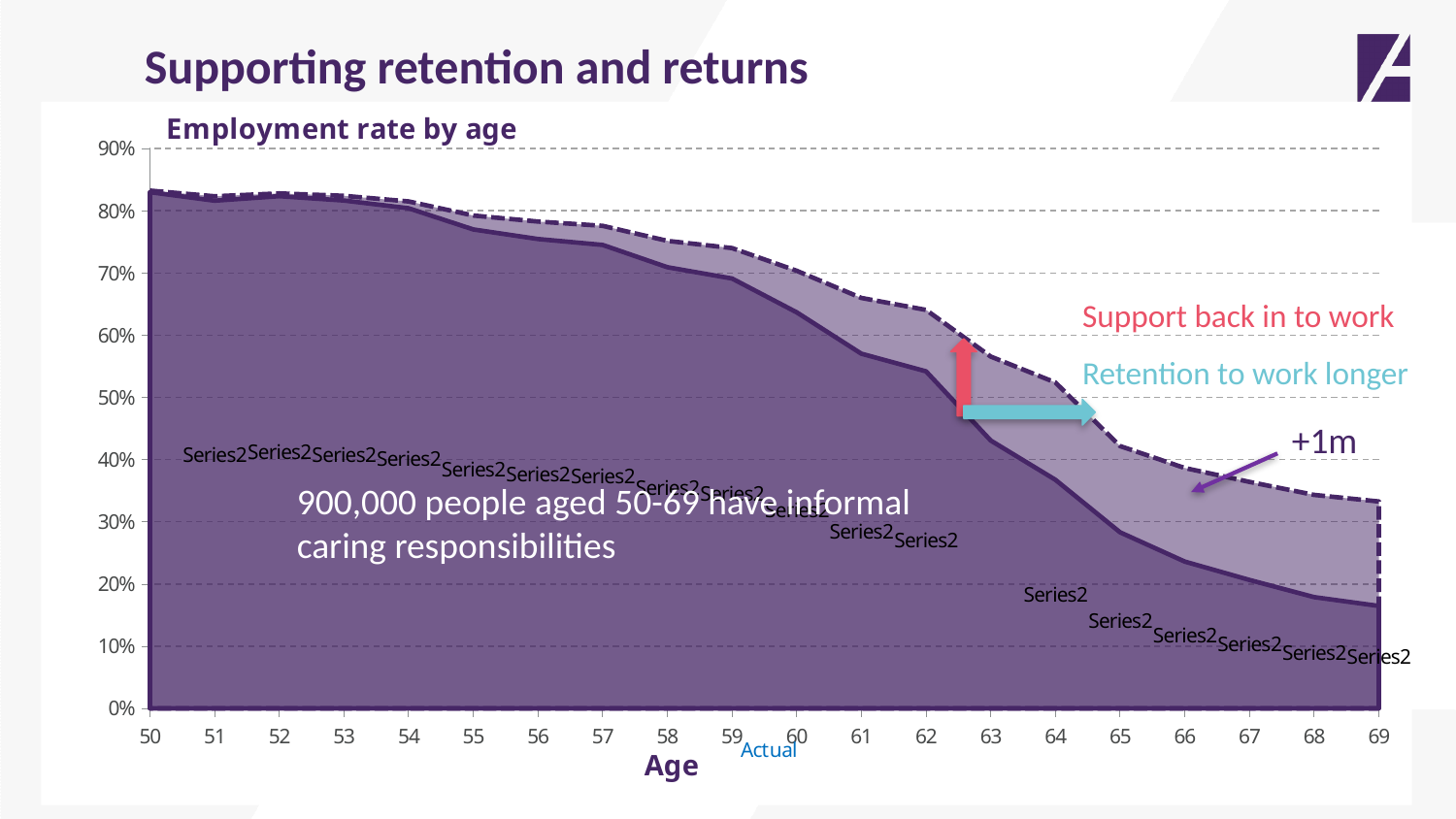
What is the label on the x axis of the chart? Age Is the actual employment rate at age 65 greater or less than 30%? less Does the employment rate rise or fall as age increases from 50 to 69? fall Is the dashed-line value at age 69 greater or less than 30%? greater At age 65, which is higher: the dashed line or the solid actual series? the dashed line Is the actual employment rate at age 62 greater or less than 50%? greater What is the title of the chart? Employment rate by age How many ages are shown along the x axis of the chart? 20 What kind of chart is shown on the slide? area chart At which age is the actual employment rate lowest? 69